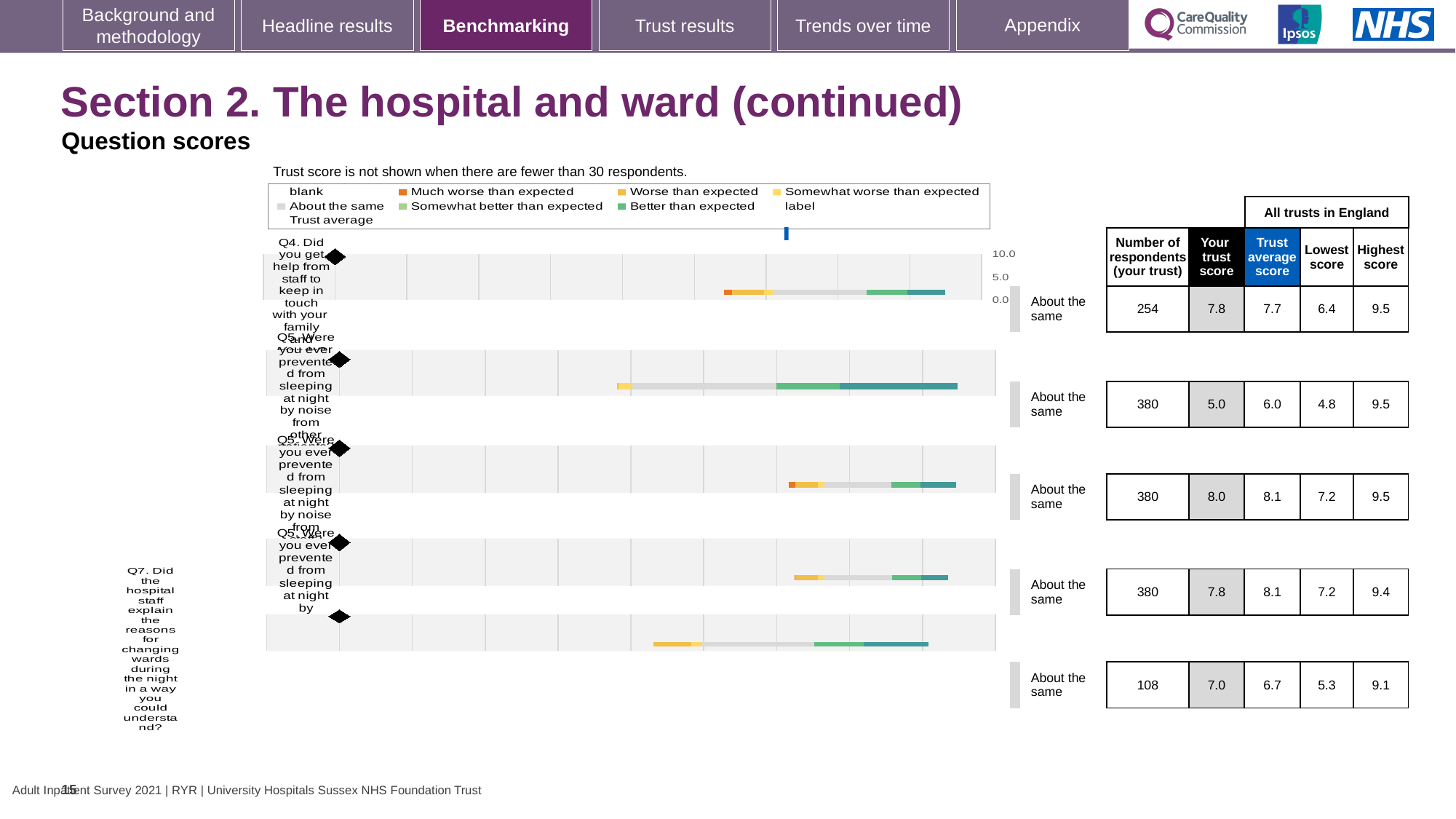
By how much does your trust score for Q4 exceed the trust average score for Q4? 0.1 Which has the higher 'Your trust score': Q4 or Q7? Q4 What is the highest score across all trusts in England for Q7? 9.1 What kind of chart is used to show the question scores on this slide? bar chart How many respondents from your trust answered Q7? 108 What is the trust average score for Q4? 7.7 How many question rows (bars) are plotted in the question scores chart? 5 What benchmark category is shown for Q4? About the same What is the 'Your trust score' for Q4 (Did you get help from staff to keep in touch with your family and friends)? 7.8 What is the lowest score across all trusts in England for Q7? 5.3 What is the 'Your trust score' for Q7 (Did the hospital staff explain the reasons for changing wards during the night in a way you could understand)? 7.0 How many respondents from your trust answered Q4? 254